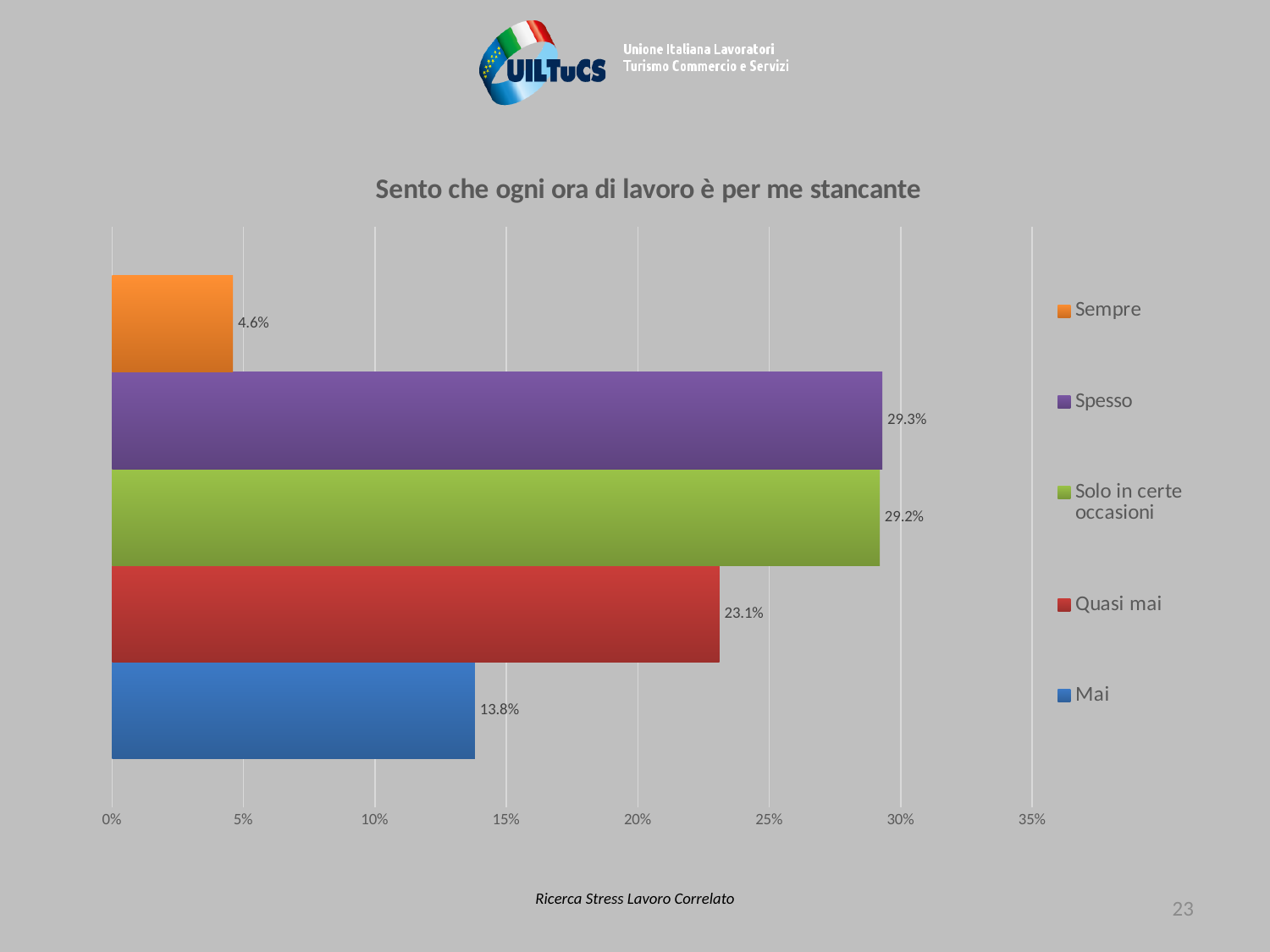
Which is larger, the value for Quasi mai or the value for Mai? Quasi mai What is the value for Mai? 13.8% Which category has the lowest value? Sempre What is the difference between the values for Quasi mai and Mai? 9.3% What is the difference between the values for Spesso and Sempre? 24.7% What is the value for Spesso? 29.3% What kind of chart is shown on the slide? Bar chart What is the value for Solo in certe occasioni? 29.2% What is the value for Quasi mai? 23.1% Is the value for Quasi mai greater or less than 20%? greater What is the value for Sempre? 4.6% How many categories are shown in the chart? 5